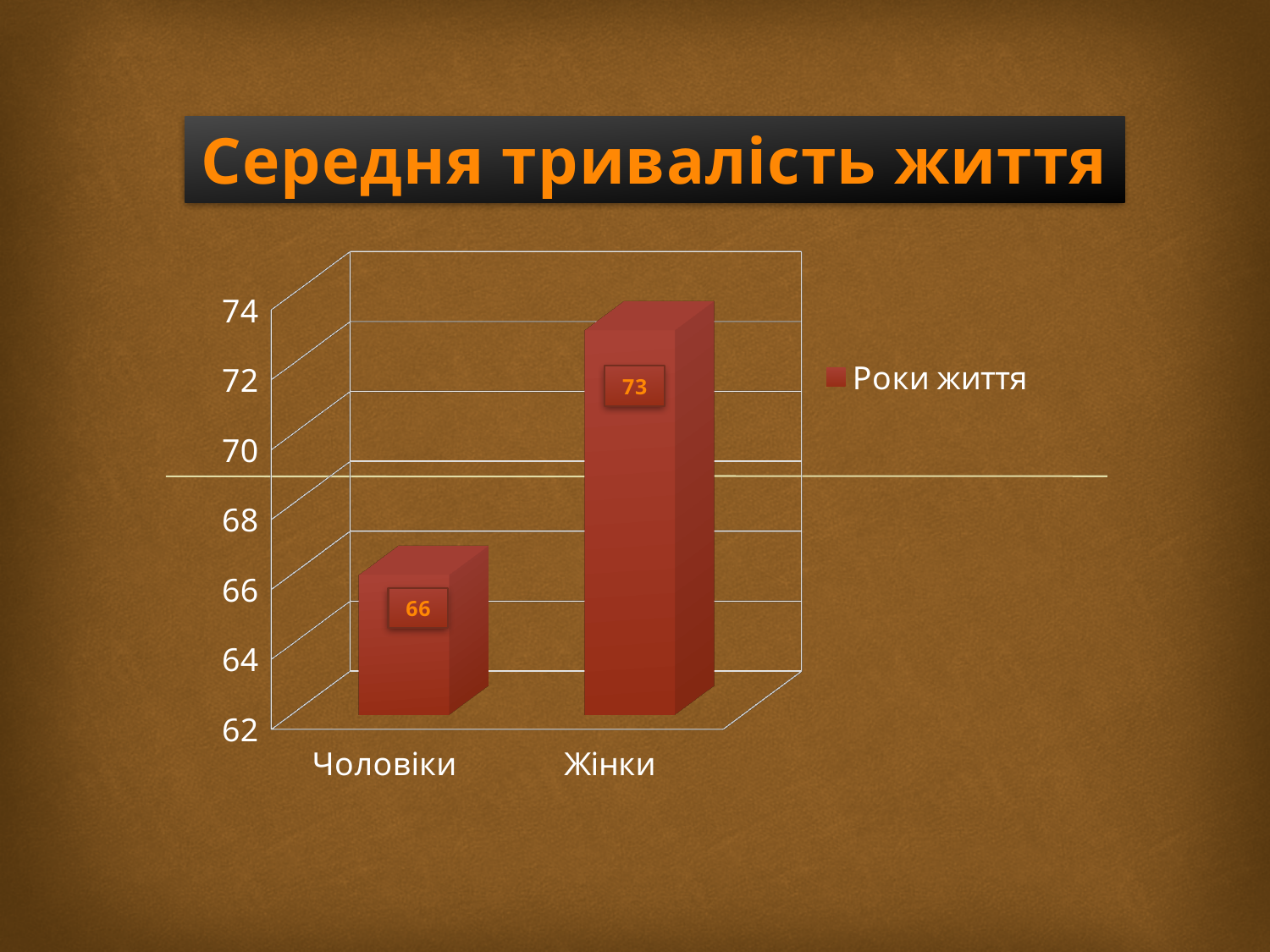
Which is larger, the value for Чоловіки or the value for Жінки? Жінки What is the title of the slide? Середня тривалість життя Which category has the highest value? Жінки Is the value for Жінки greater or less than 70? greater What is the difference between the values for Жінки and Чоловіки? 7 What is the value for Чоловіки? 66 What is the value for Жінки? 73 Is the value for Чоловіки greater or less than 70? less Which category has the lowest value? Чоловіки How many categories are shown on the x axis? 2 What kind of chart is shown on the slide? bar chart How many series does the legend list? 1